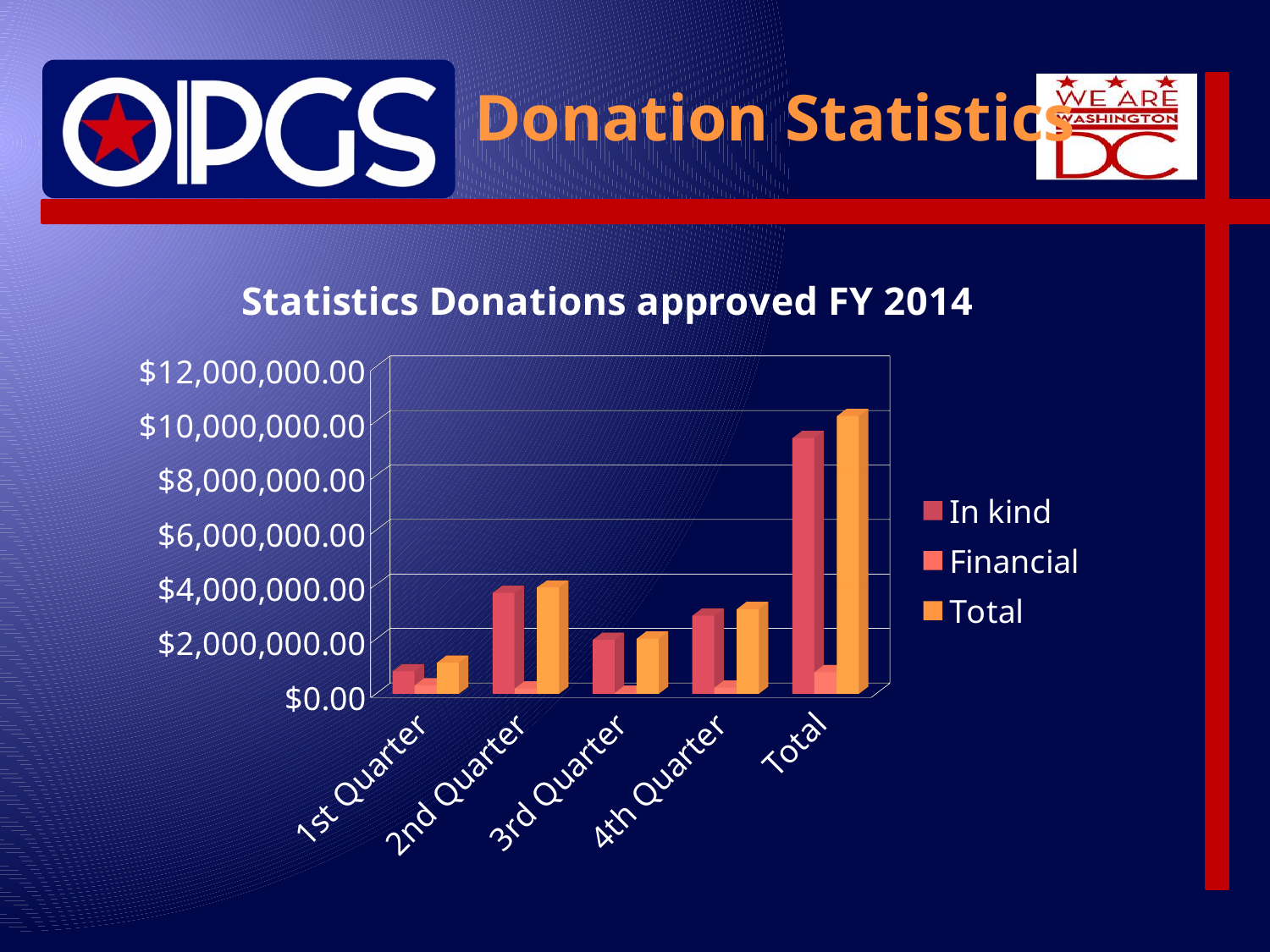
Among the four quarters, which has the highest value for the Total series? 2nd Quarter Which is larger in the 3rd Quarter, the In kind value or the Financial value? In kind Is the value for the Total series in the Total category greater or less than $8,000,000.00? greater What is the title of the chart? Statistics Donations approved FY 2014 How many categories are shown on the x axis? 5 Among the four quarters, which has the lowest value for the In kind series? 1st Quarter Is the value for the In kind series in the 1st Quarter greater or less than $2,000,000.00? less Which series is shown in orange in the legend? Total Which category has the highest value for the Total series? Total What kind of chart is shown on the slide? Bar chart How many series does the legend list? 3 Is the value for the Total series in the 2nd Quarter greater or less than $2,000,000.00? greater